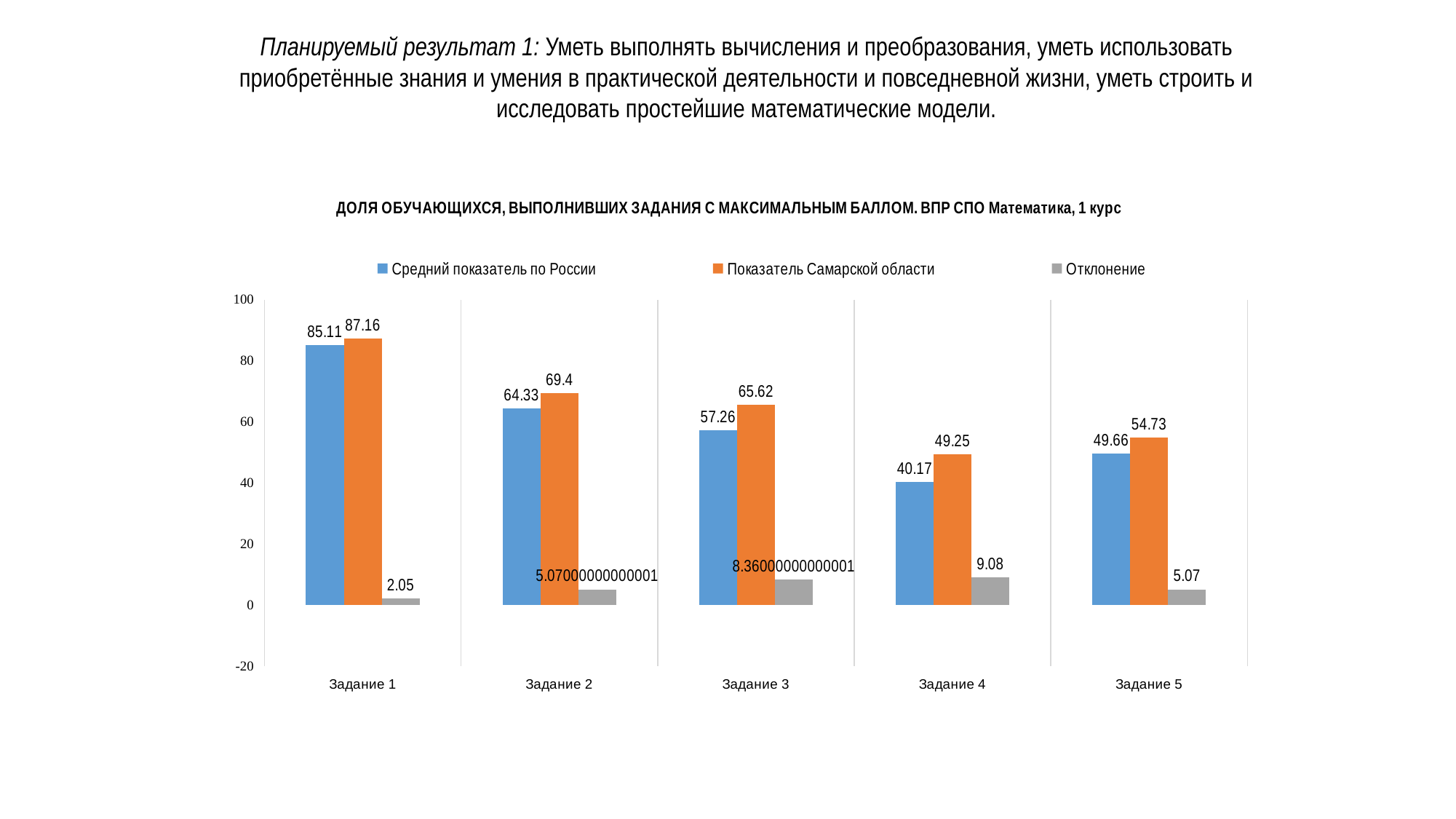
What is the difference between Показатель Самарской области and Средний показатель по России for Задание 4? 9.08 What is the value of Средний показатель по России for Задание 1? 85.11 What is the Отклонение value for Задание 5? 5.07 What is the value of Показатель Самарской области for Задание 4? 49.25 Which task has the highest value for Показатель Самарской области? Задание 1 What kind of chart is shown on the slide? Bar chart Is the value of Средний показатель по России for Задание 2 greater or less than 60? greater Which series is shown in orange? Показатель Самарской области Which is larger for Задание 3: Средний показатель по России or Показатель Самарской области? Показатель Самарской области How many tasks (categories) are shown on the x axis? 5 Which task has the lowest value for Средний показатель по России? Задание 4 How many series does the legend list? 3